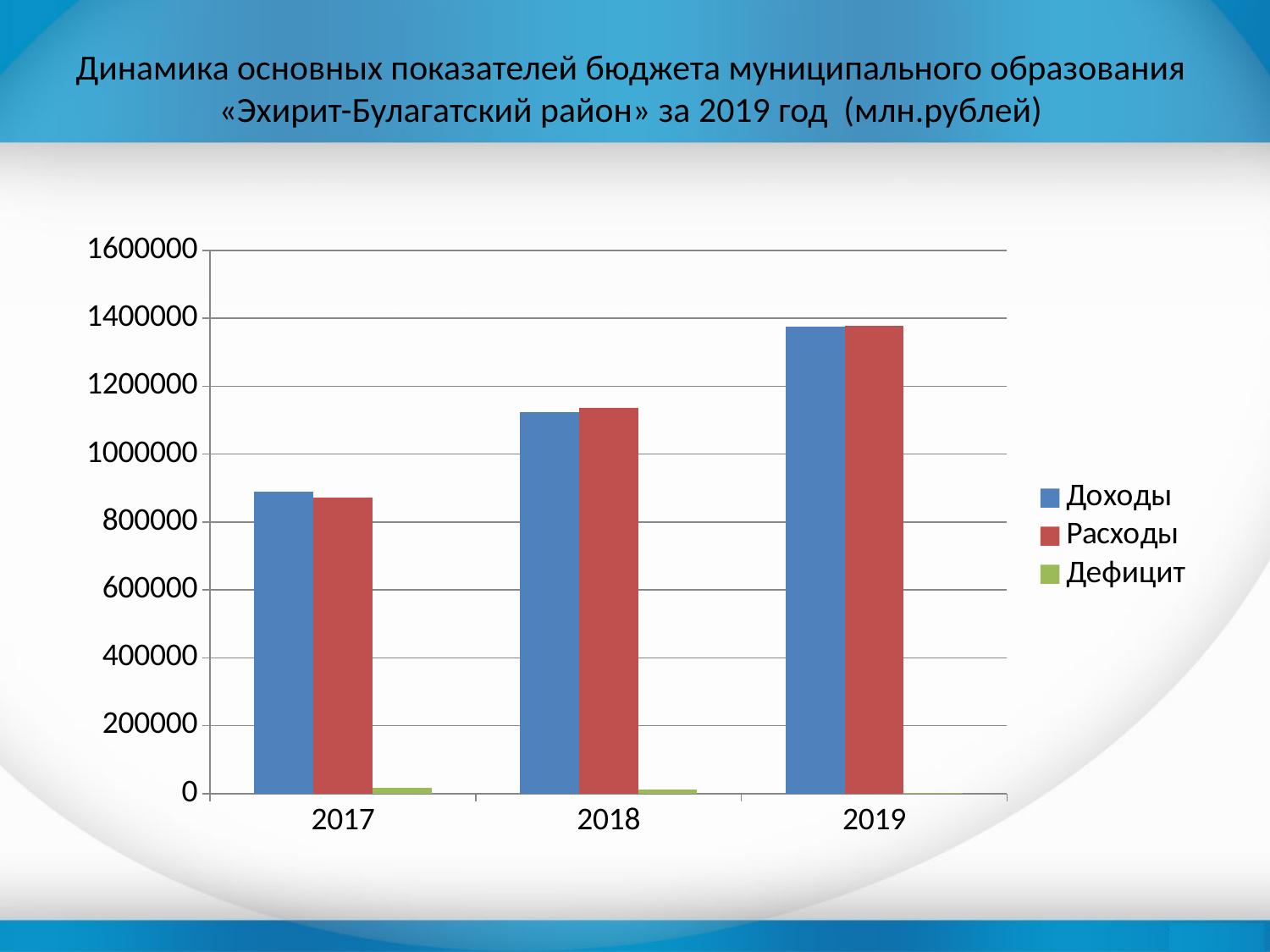
Is the value for Доходы in 2019 greater or less than 1400000? less What kind of chart is shown on the slide? bar chart Which year has the lowest value for Расходы? 2017 Do the values for Доходы rise or fall from 2017 to 2019? rise Which series is shown in red in the chart legend? Расходы How many years are shown on the x axis of the chart? 3 Which year has the highest value for Доходы? 2019 How many series does the chart legend list? 3 Which is larger: Расходы in 2019 or Расходы in 2017? Расходы in 2019 Is the value for Доходы in 2017 greater or less than 800000? greater Is the value for Расходы in 2018 greater or less than 1000000? greater